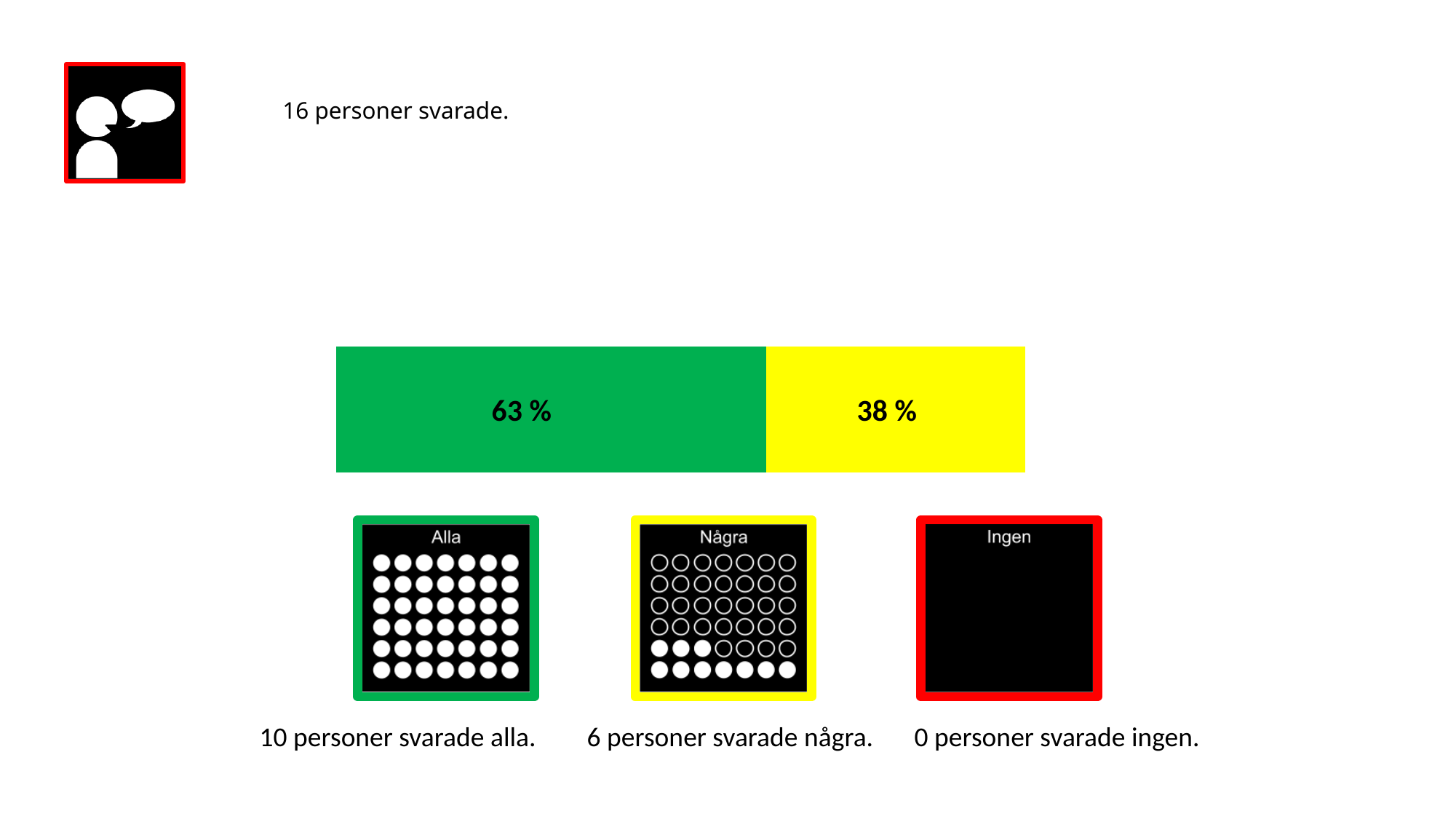
What percentage is printed on the yellow segment of the stacked bar? 38 % How many segments does the stacked bar have? 2 What is the difference between the green segment value and the yellow segment value? 25 % What percentage is printed on the green segment of the stacked bar? 63 % What colour is the larger segment of the stacked bar? Green Which segment of the stacked bar is the largest? The green segment (63 %) According to the pictogram boxes, how many people answered 'Ingen'? 0 Which is larger, the green segment or the yellow segment of the bar? The green segment According to the pictogram boxes, how many people answered 'Alla'? 10 What kind of chart is shown in the middle of the slide? A stacked horizontal bar chart Which segment of the stacked bar is the smallest? The yellow segment (38 %) According to the pictogram boxes, how many people answered 'Några'? 6